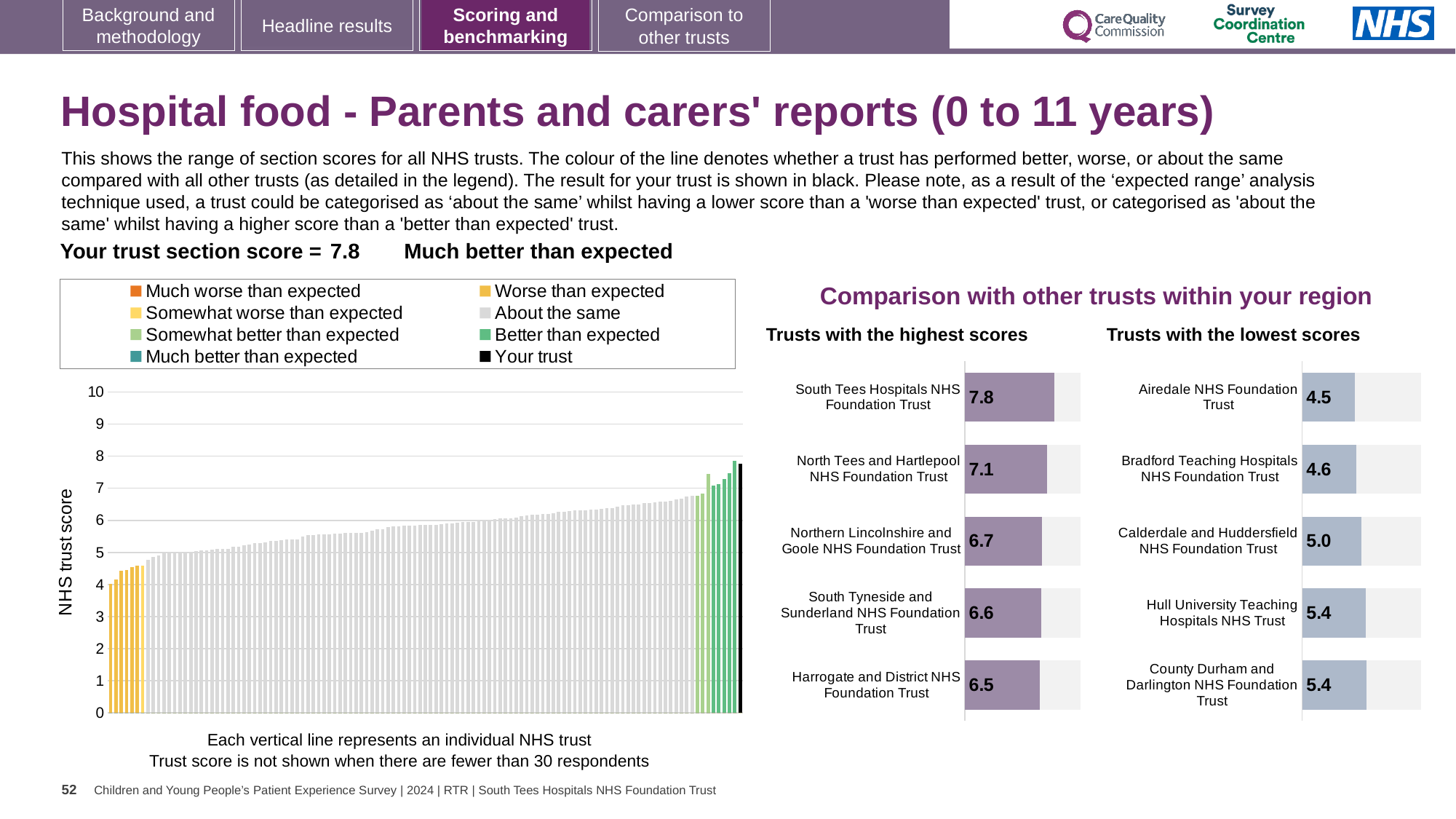
In the 'Trusts with the highest scores' chart, which trust has the highest score? South Tees Hospitals NHS Foundation Trust In the large chart on the left, is the value of the black 'Your trust' bar greater or less than 7? greater How many entries does the legend of the large chart on the left list? 8 What kind of chart is the large chart on the left with the 'NHS trust score' axis? Bar chart In the 'Trusts with the lowest scores' chart, which trust has the lowest score? Airedale NHS Foundation Trust In the large chart on the left, do the trust scores rise or fall from left to right? Rise In the 'Trusts with the lowest scores' chart, which has the larger score: Bradford Teaching Hospitals NHS Foundation Trust or Calderdale and Huddersfield NHS Foundation Trust? Calderdale and Huddersfield NHS Foundation Trust In the 'Trusts with the lowest scores' chart, what is the score for Calderdale and Huddersfield NHS Foundation Trust? 5.0 In the 'Trusts with the highest scores' chart, what is the score for North Tees and Hartlepool NHS Foundation Trust? 7.1 In the 'Trusts with the lowest scores' chart, what is the difference between the scores of Calderdale and Huddersfield NHS Foundation Trust and Airedale NHS Foundation Trust? 0.5 In the 'Trusts with the highest scores' chart, how many trusts are shown? 5 In the 'Trusts with the highest scores' chart, what is the difference between the scores of South Tees Hospitals NHS Foundation Trust and Harrogate and District NHS Foundation Trust? 1.3